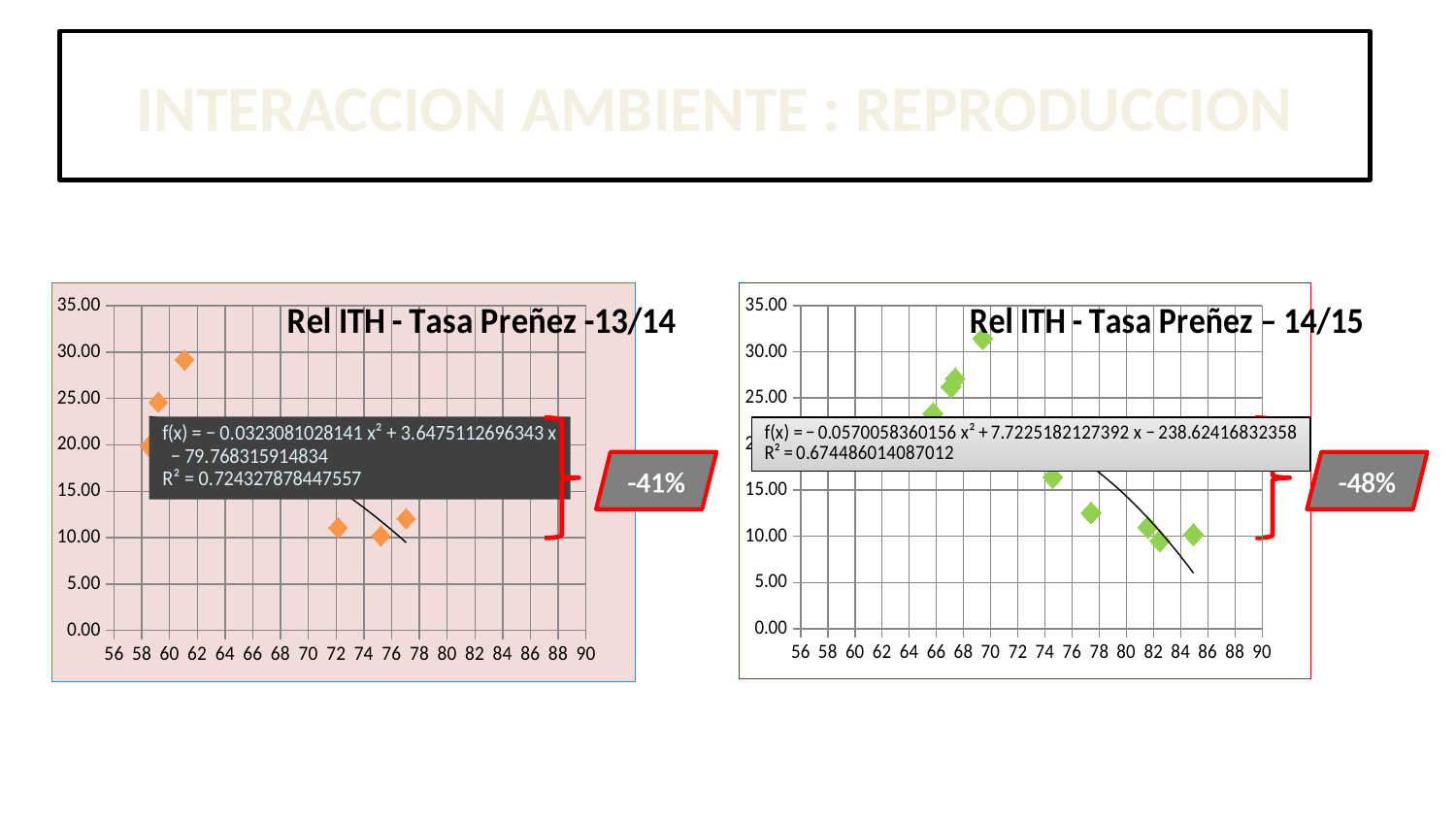
In the left chart 'Rel ITH - Tasa Preñez -13/14', do the plotted values generally rise or fall as the x-axis value increases? fall In the right chart 'Rel ITH - Tasa Preñez – 14/15', is the highest plotted point greater or less than 30.00? greater What kind of chart is the left chart titled 'Rel ITH - Tasa Preñez -13/14'? scatter chart In the right chart 'Rel ITH - Tasa Preñez – 14/15', do the plotted values generally rise or fall as the x-axis value increases? fall What percentage is shown in the callout next to the left chart 'Rel ITH - Tasa Preñez -13/14'? -41% In the right chart 'Rel ITH - Tasa Preñez – 14/15', what R² value is printed for the trendline? 0.674486014087012 In the right chart 'Rel ITH - Tasa Preñez – 14/15', is the point plotted near x = 77 greater or less than 15.00? less In the left chart 'Rel ITH - Tasa Preñez -13/14', what R² value is printed for the trendline? 0.724327878447557 Which chart has the higher printed R² value, the left chart (13/14) or the right chart (14/15)? the left chart (13/14) In the left chart 'Rel ITH - Tasa Preñez -13/14', is the highest plotted point greater or less than 25.00? greater What colour are the data points in the right chart 'Rel ITH - Tasa Preñez – 14/15'? green What kind of chart is the right chart titled 'Rel ITH - Tasa Preñez – 14/15'? scatter chart